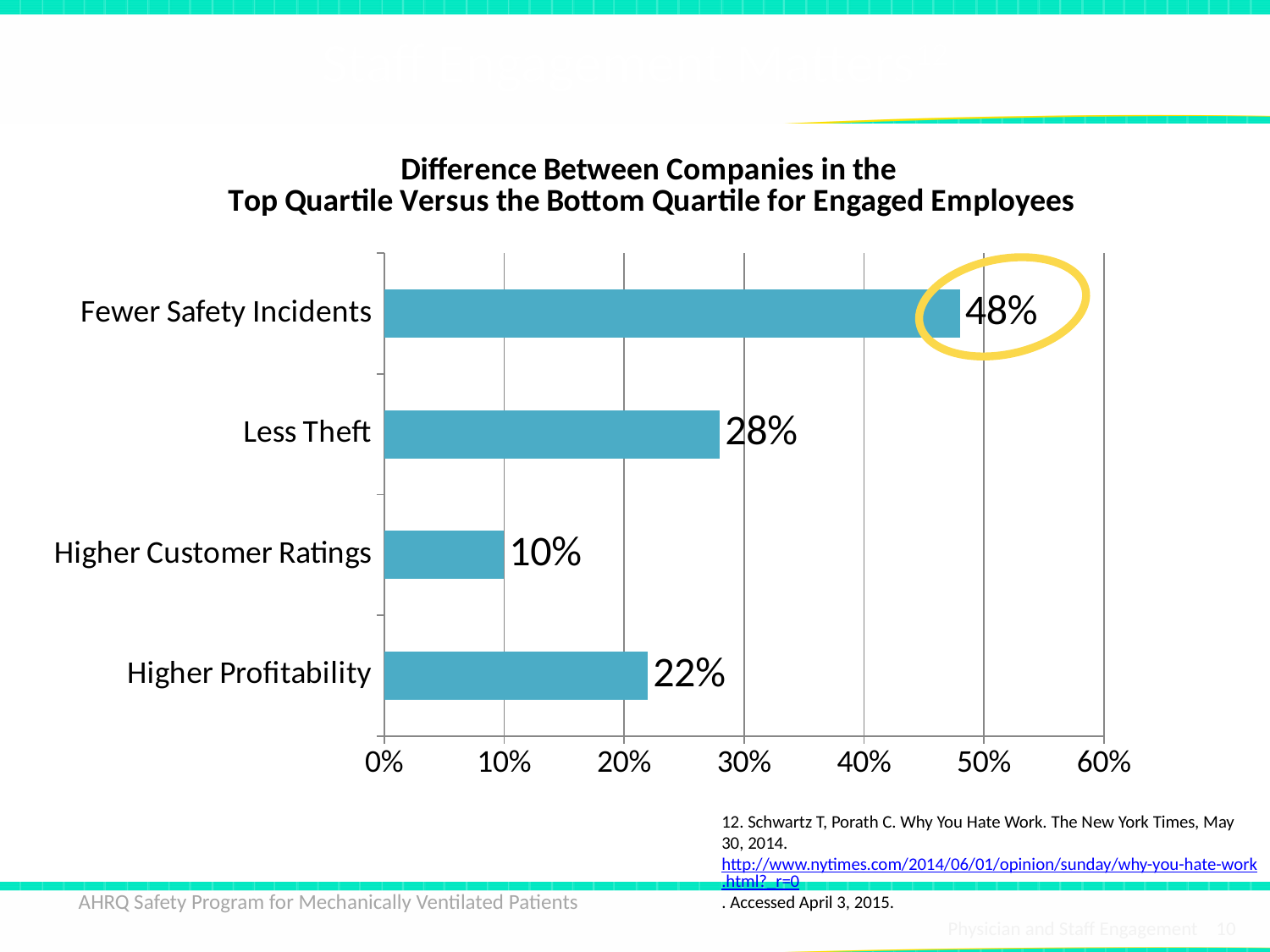
What is the difference between the values for Fewer Safety Incidents and Less Theft? 20% What is the value for Higher Profitability? 22% Which category has the highest value? Fewer Safety Incidents Is the value for Less Theft greater or less than 30%? less Which is larger, the value for Less Theft or the value for Higher Profitability? Less Theft Which category has the lowest value? Higher Customer Ratings How many categories are shown in the chart? 4 What is the difference between the values for Higher Profitability and Higher Customer Ratings? 12% What is the value for Less Theft? 28% What is the value for Higher Customer Ratings? 10% What kind of chart is shown on the slide? Bar chart What is the value for Fewer Safety Incidents? 48%